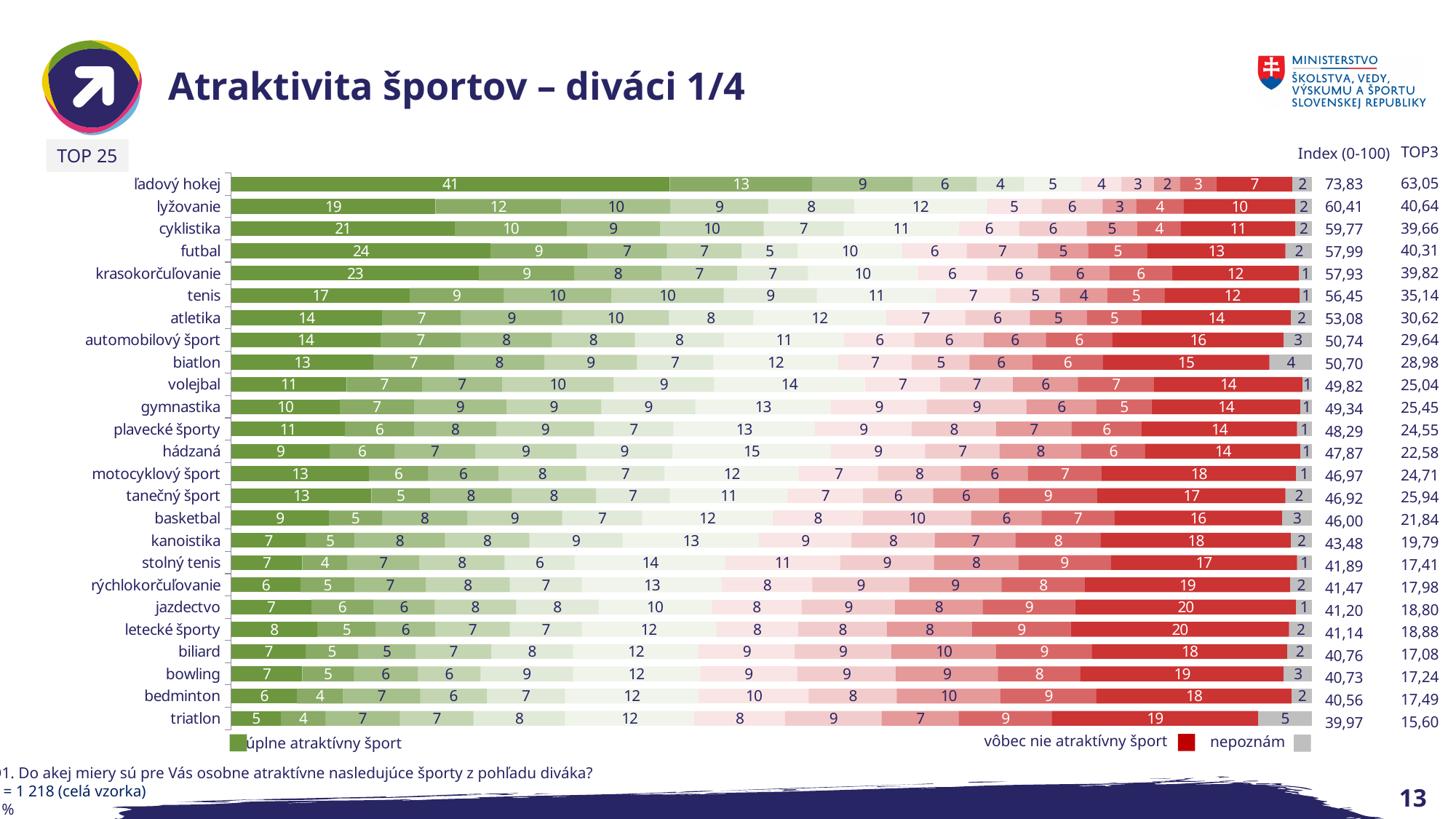
Which sport has the lowest Index (0-100) value? triatlon What is the 'nepoznám' value for triatlon? 5 What label does the legend give to the dark green segment? úplne atraktívny šport What is the 'vôbec nie atraktívny šport' value for jazdectvo? 20 What is the Index (0-100) value for futbal? 57,99 Which sport has the highest Index (0-100) value? ľadový hokej What kind of chart is shown on the slide? bar chart How many sports are listed in the chart? 25 What is the value of the 'úplne atraktívny šport' segment for ľadový hokej? 41 Which has a larger 'úplne atraktívny šport' value, futbal or tenis? futbal What is the difference between the Index (0-100) values of ľadový hokej and lyžovanie? 13,42 What is the TOP3 value for ľadový hokej? 63,05